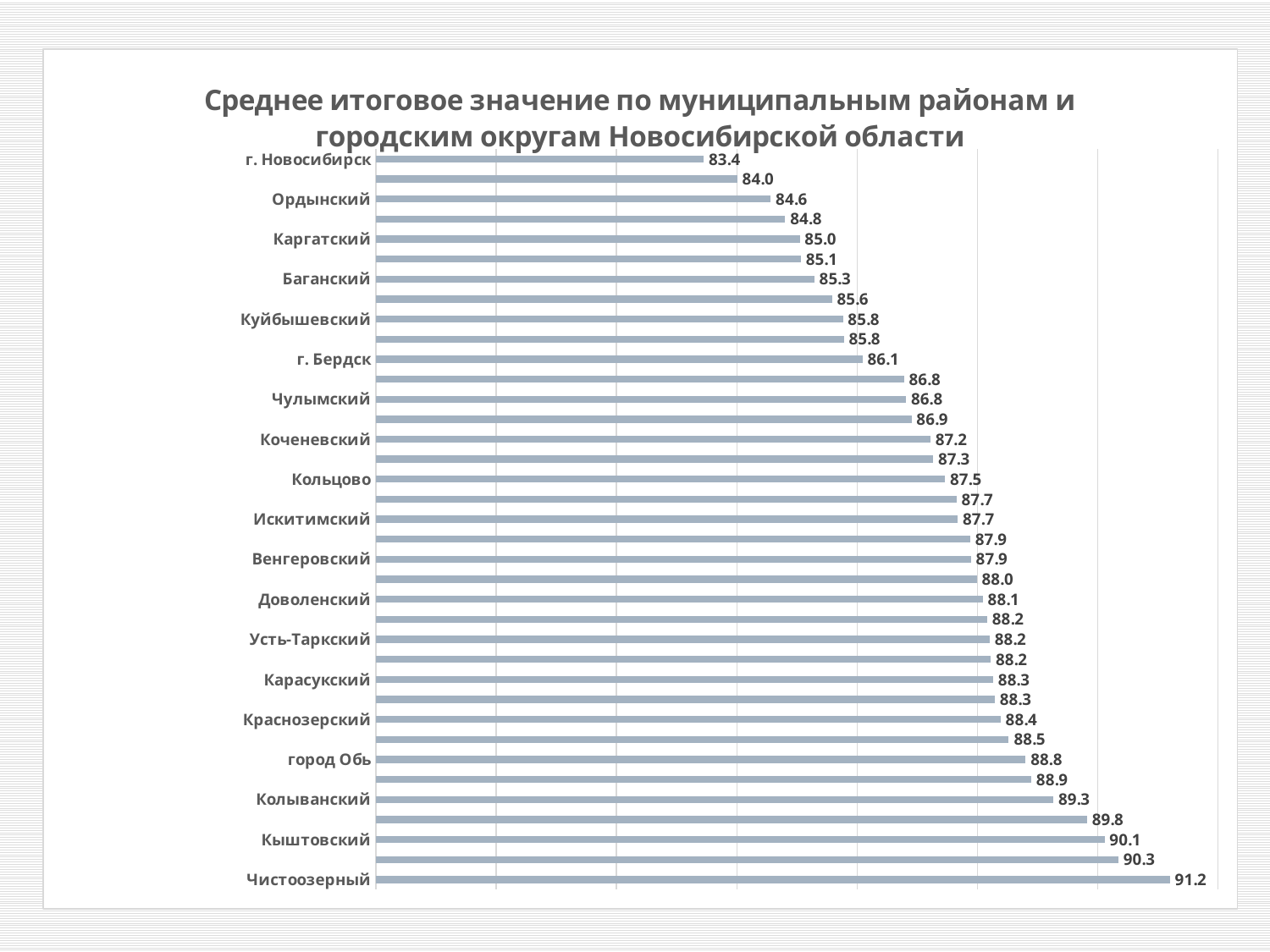
What is the difference between the values for Кыштовский and г. Бердск? 4.0 What is the value for город Обь? 88.8 Which labelled category has the lowest value? г. Новосибирск What is the title of the chart? Среднее итоговое значение по муниципальным районам и городским округам Новосибирской области What is the value for Кольцово? 87.5 What is the value for г. Новосибирск? 83.4 What is the difference between the values for Чистоозерный and г. Новосибирск? 7.8 What is the value for Чистоозерный? 91.2 Which labelled category has the highest value? Чистоозерный Which has a larger value, Колыванский or Ордынский? Колыванский What is the value for Кыштовский? 90.1 What type of chart is shown on the slide? bar chart